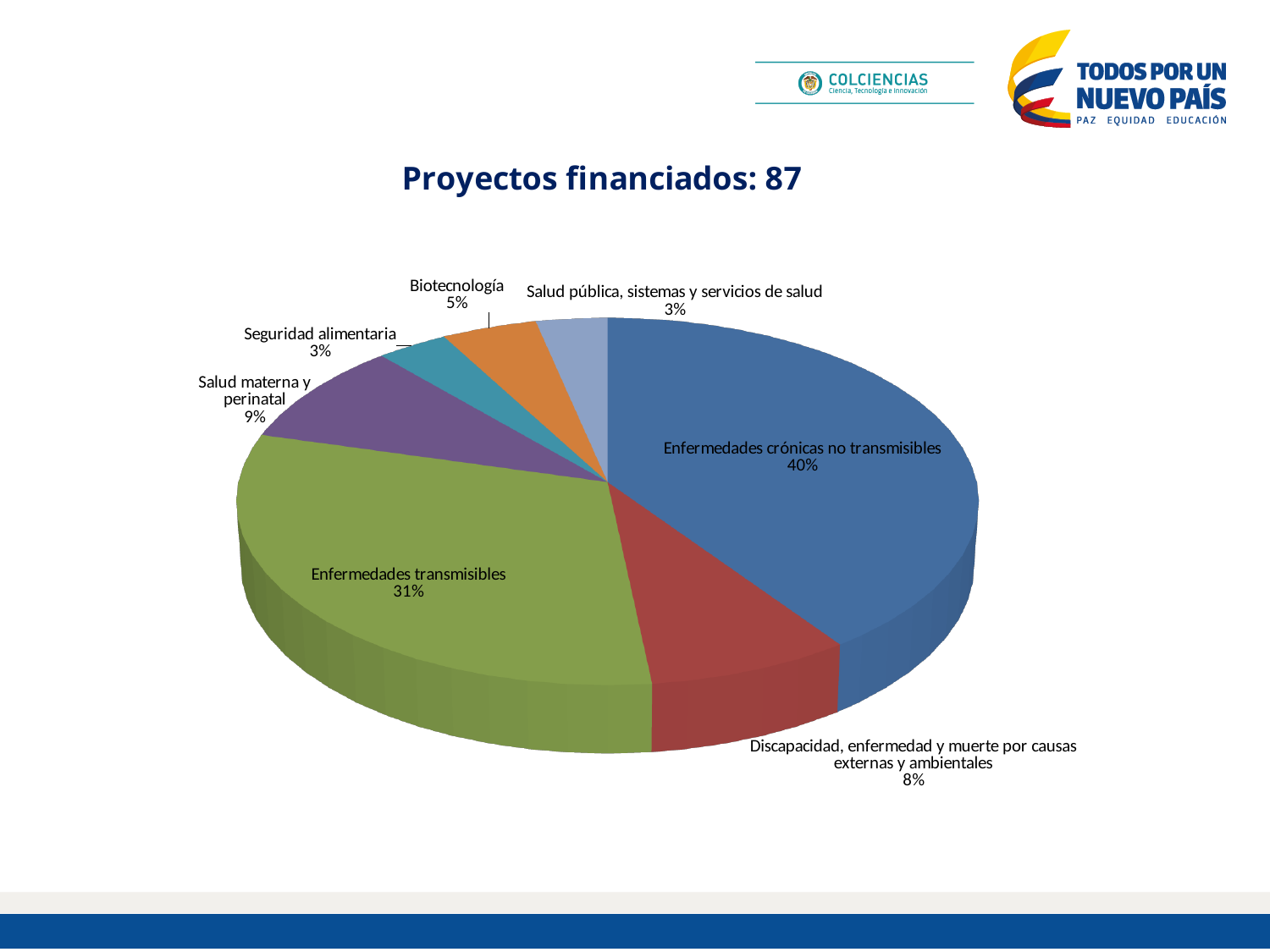
What share of the pie does Enfermedades crónicas no transmisibles represent? 40% What percentage is shown for Salud pública, sistemas y servicios de salud? 3% What percentage is shown for Enfermedades transmisibles? 31% What is the difference in percentage points between Biotecnología and Seguridad alimentaria? 2 What percentage is shown for Biotecnología? 5% What is the title shown above the chart? Proyectos financiados: 87 What type of chart is shown on the slide? Pie chart Which is larger, the slice for Salud materna y perinatal or the slice for Discapacidad, enfermedad y muerte por causas externas y ambientales? Salud materna y perinatal How many categories are shown in the pie chart? 7 Which category has the largest slice of the pie? Enfermedades crónicas no transmisibles What is the difference in percentage points between Enfermedades crónicas no transmisibles and Enfermedades transmisibles? 9 What percentage is shown for Salud materna y perinatal? 9%